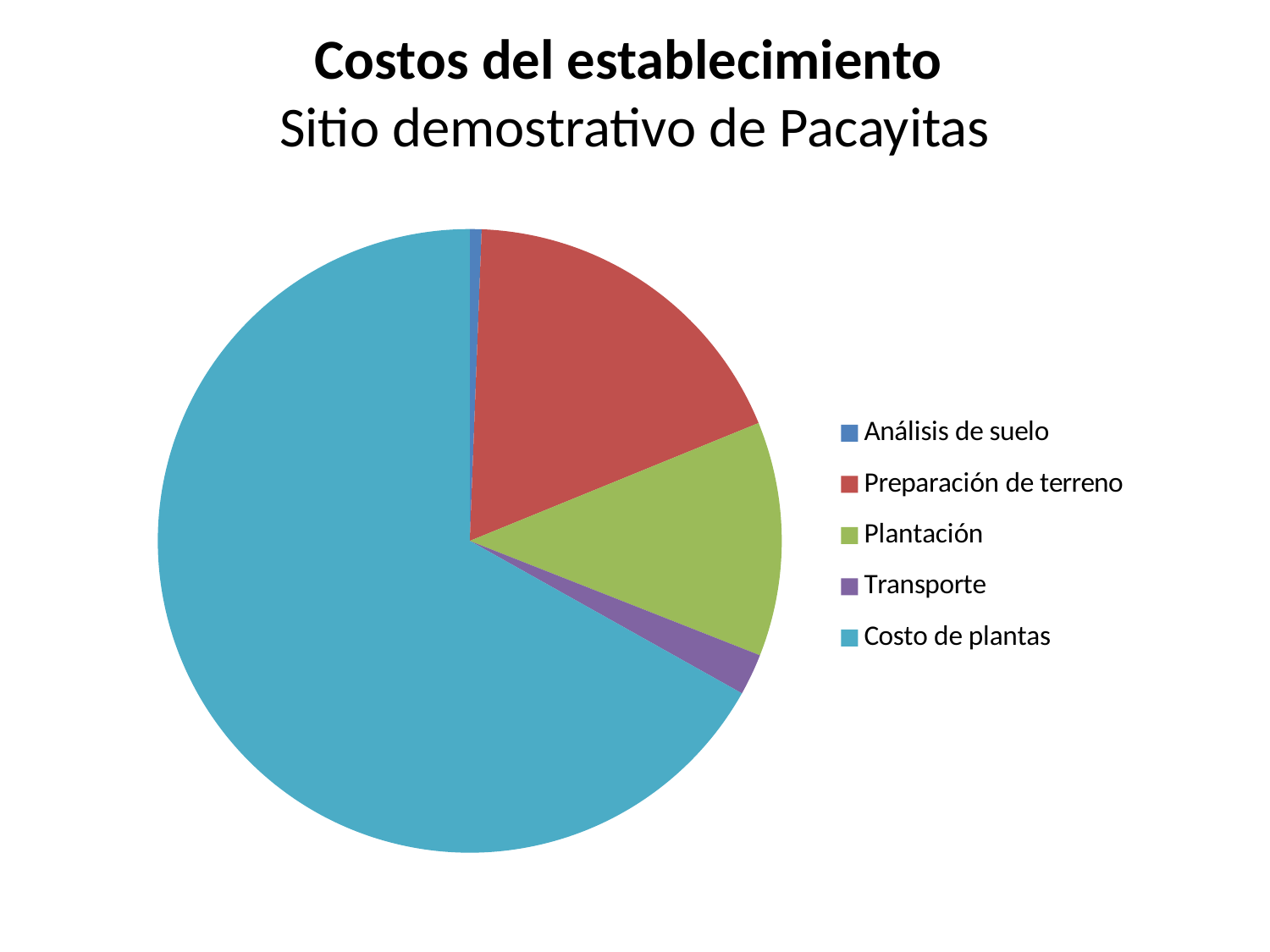
What is the title of the chart? Costos del establecimiento Sitio demostrativo de Pacayitas How many entries does the legend list? 5 What colour is the Plantación slice? Green Which slice is larger, Costo de plantas or Preparación de terreno? Costo de plantas Which category has the largest slice of the pie? Costo de plantas Which category has the smallest slice of the pie? Análisis de suelo Which slice is larger, Transporte or Análisis de suelo? Transporte What kind of chart is shown on the slide? Pie chart How many categories (slices) does the pie chart have? 5 Which slice is larger, Transporte or Plantación? Plantación